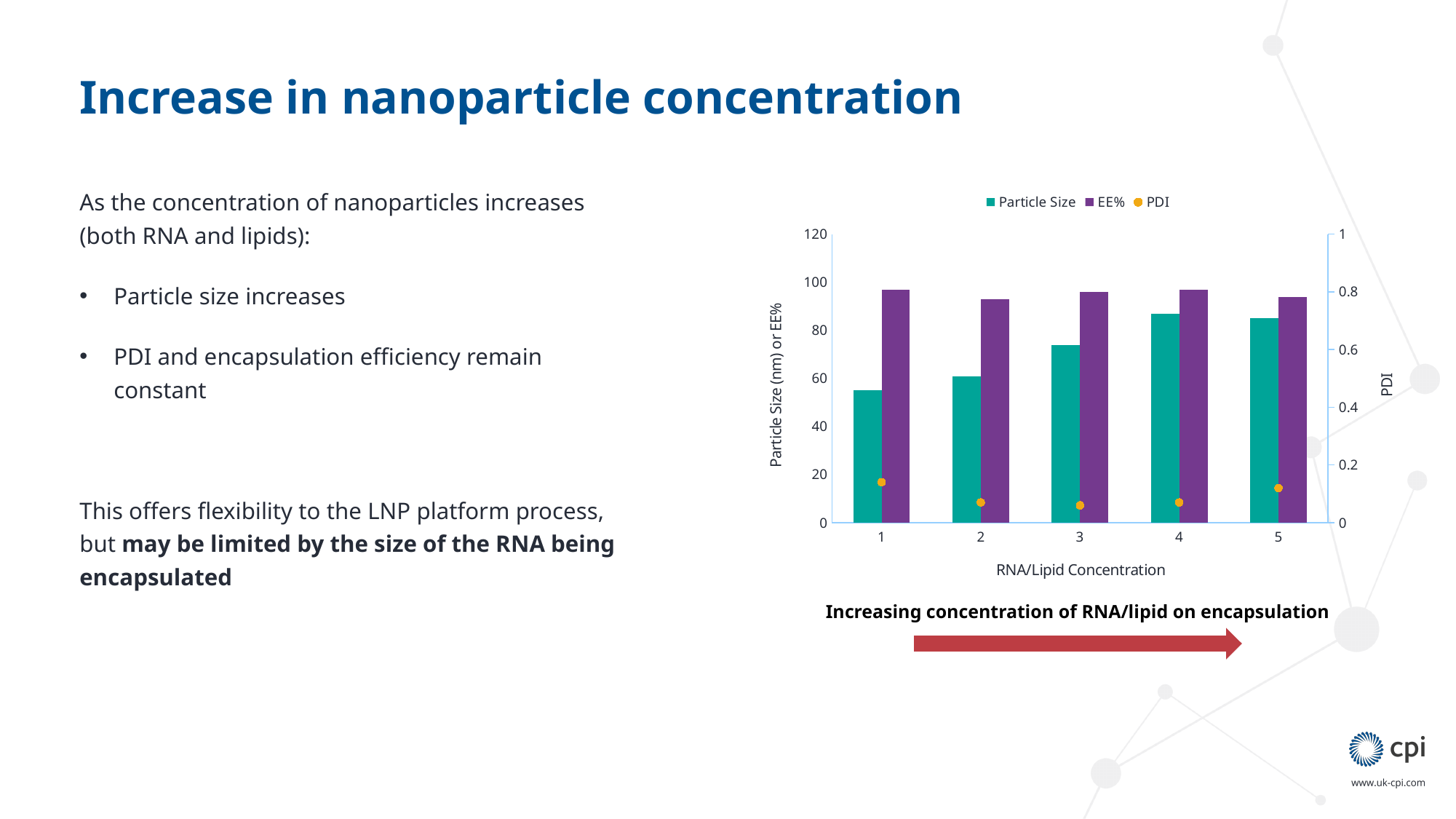
How many series does the chart legend list? 3 Which RNA/Lipid Concentration category has the lowest Particle Size? 1 How many RNA/Lipid Concentration categories are shown on the x axis? 5 Is the Particle Size value at RNA/Lipid Concentration 1 greater or less than 60? less Is the EE% value at RNA/Lipid Concentration 1 greater or less than 80? greater Is the PDI value at RNA/Lipid Concentration 1 greater or less than 0.2? less Is the Particle Size larger at RNA/Lipid Concentration 3 or at RNA/Lipid Concentration 1? 3 What is the title of the right-hand vertical axis? PDI What kind of chart is used to show Particle Size and EE%? Bar chart Do the Particle Size values generally rise or fall as RNA/Lipid Concentration increases from 1 to 5? rise At RNA/Lipid Concentration 1, which is larger: Particle Size or EE%? EE%